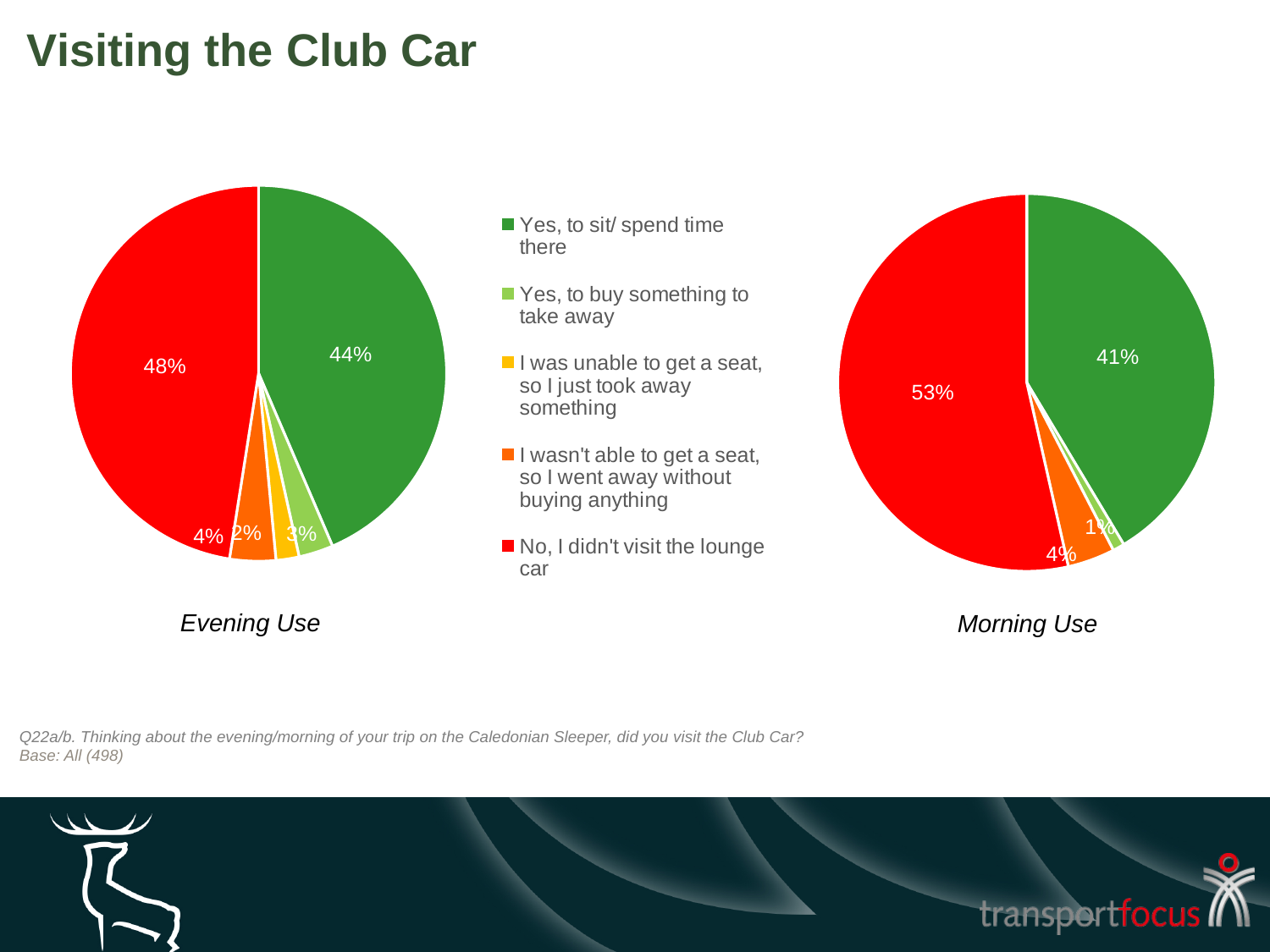
In the Evening Use pie chart, which category has the largest share? No, I didn't visit the lounge car In the Evening Use pie chart, which category has the smallest share? I was unable to get a seat, so I just took away something What type of chart is used to show Evening Use and Morning Use? Pie chart How many categories does the legend list for the pie charts? 5 In the Morning Use pie chart, what percentage said 'No, I didn't visit the lounge car'? 53% In the Evening Use pie chart, what percentage said 'Yes, to sit/ spend time there'? 44% In the Morning Use pie chart, what percentage said 'Yes, to sit/ spend time there'? 41% In the Evening Use pie chart, what percentage said 'Yes, to buy something to take away'? 3% In the Evening Use pie chart, what percentage said 'I wasn't able to get a seat, so I went away without buying anything'? 4% In the Evening Use pie chart, what percentage of respondents said 'No, I didn't visit the lounge car'? 48% What is the difference between the 'No, I didn't visit the lounge car' share in the Morning Use chart and in the Evening Use chart? 5% Which is larger: the 'Yes, to sit/ spend time there' share in the Evening Use chart or in the Morning Use chart? Evening Use